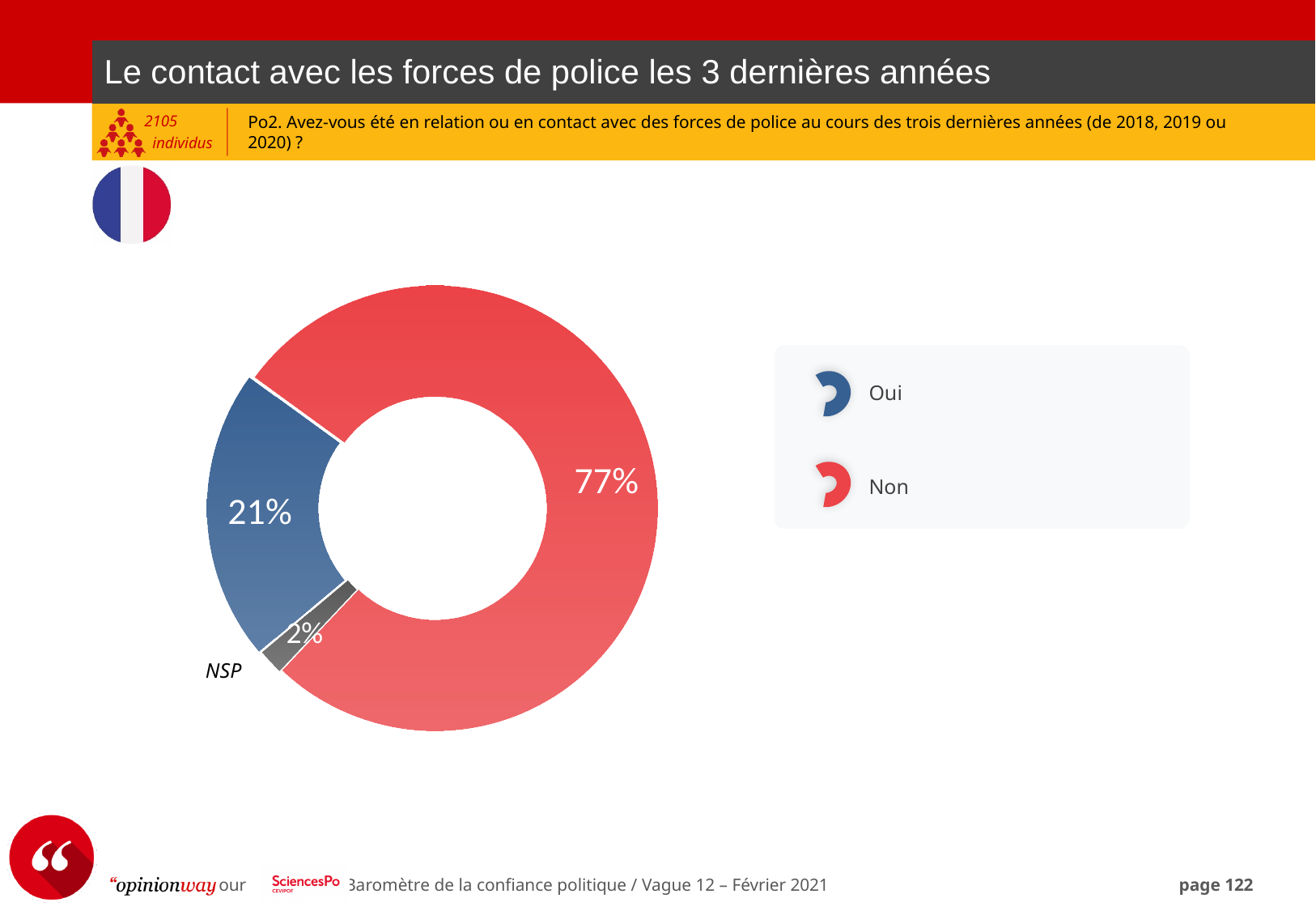
What is the difference in percentage points between "Non" and "Oui"? 56 What kind of chart is shown on the slide? Pie chart (donut) How many slices does the pie chart have? 3 What percentage of respondents answered "Oui"? 21% What is the title of the slide? Le contact avec les forces de police les 3 dernières années Which response has the smallest share of the pie? NSP What colour is the "Oui" slice? Blue What percentage of respondents answered "Non"? 77% How many entries does the legend list? 2 What percentage is shown for the NSP slice? 2% Which response has the largest share of the pie? Non Which is larger, the share for "Oui" or the share for "Non"? Non